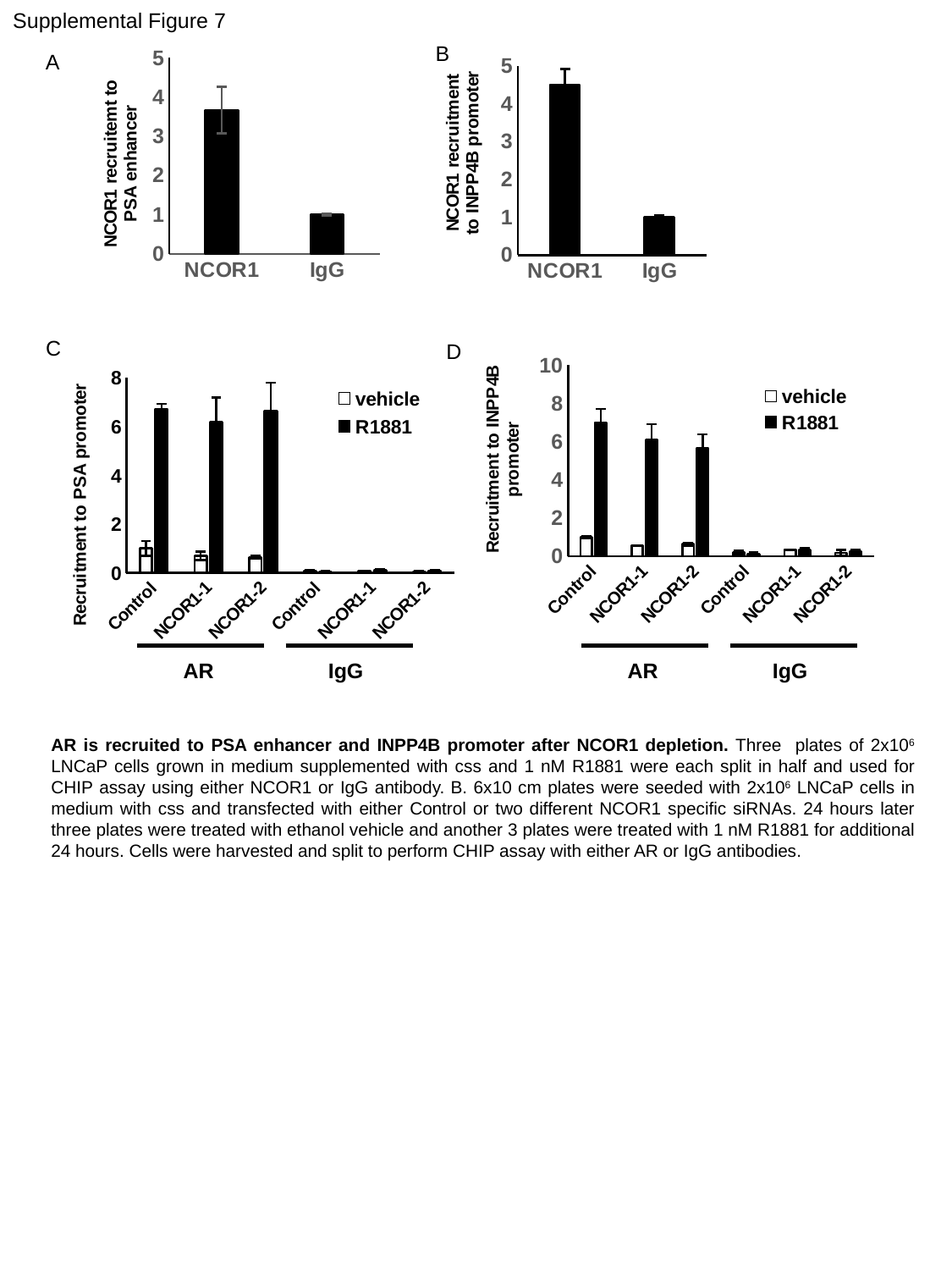
In chart C (Recruitment to PSA promoter), how many series does the legend list? 2 In chart B (NCOR1 recruitment to INPP4B promoter), which bar is lowest? IgG In chart B (NCOR1 recruitment to INPP4B promoter), is the value for NCOR1 greater or less than 4? greater What kind of chart is chart A (NCOR1 recruitment to PSA enhancer)? bar chart In chart A (NCOR1 recruitment to PSA enhancer), is the value for NCOR1 greater or less than 3? greater In chart A (NCOR1 recruitment to PSA enhancer), which bar is highest? NCOR1 In chart C (Recruitment to PSA promoter), how many categories are shown on the x axis? 6 In chart D (Recruitment to INPP4B promoter), is the R1881 value for AR Control greater or less than 6? greater In chart A (NCOR1 recruitment to PSA enhancer), how many bars are plotted? 2 In chart D (Recruitment to INPP4B promoter), which is larger for R1881: AR Control or AR NCOR1-2? AR Control What are the two legend entries in chart D (Recruitment to INPP4B promoter)? vehicle and R1881 In chart C (Recruitment to PSA promoter), for the AR Control category, which is larger: vehicle or R1881? R1881